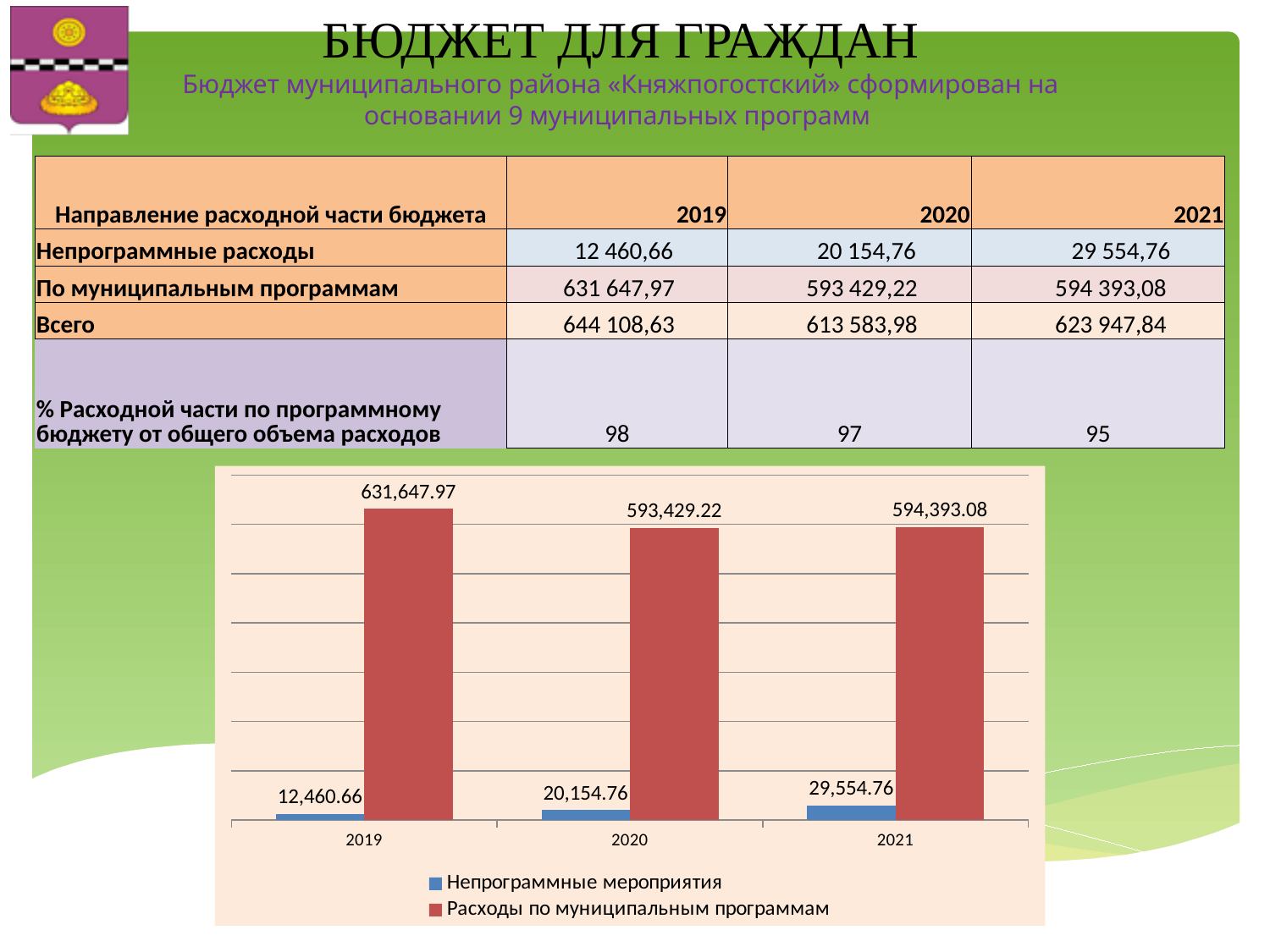
What is the difference between Непрограммные мероприятия in 2021 and in 2019? 17,094.10 What is the value for Расходы по муниципальным программам in 2021? 594,393.08 In which year is Расходы по муниципальным программам highest? 2019 In which year is Непрограммные мероприятия lowest? 2019 Which is larger: Непрограммные мероприятия in 2020 or in 2021? 2021 What is the difference between Расходы по муниципальным программам in 2019 and in 2020? 38,218.75 Does the value for Непрограммные мероприятия rise or fall from 2019 to 2021? rise What is the value for Непрограммные мероприятия in 2019? 12,460.66 What is the value for Расходы по муниципальным программам in 2020? 593,429.22 How many series does the chart legend list? 2 What is the value for Непрограммные мероприятия in 2021? 29,554.76 How many years are shown on the x axis of the chart? 3